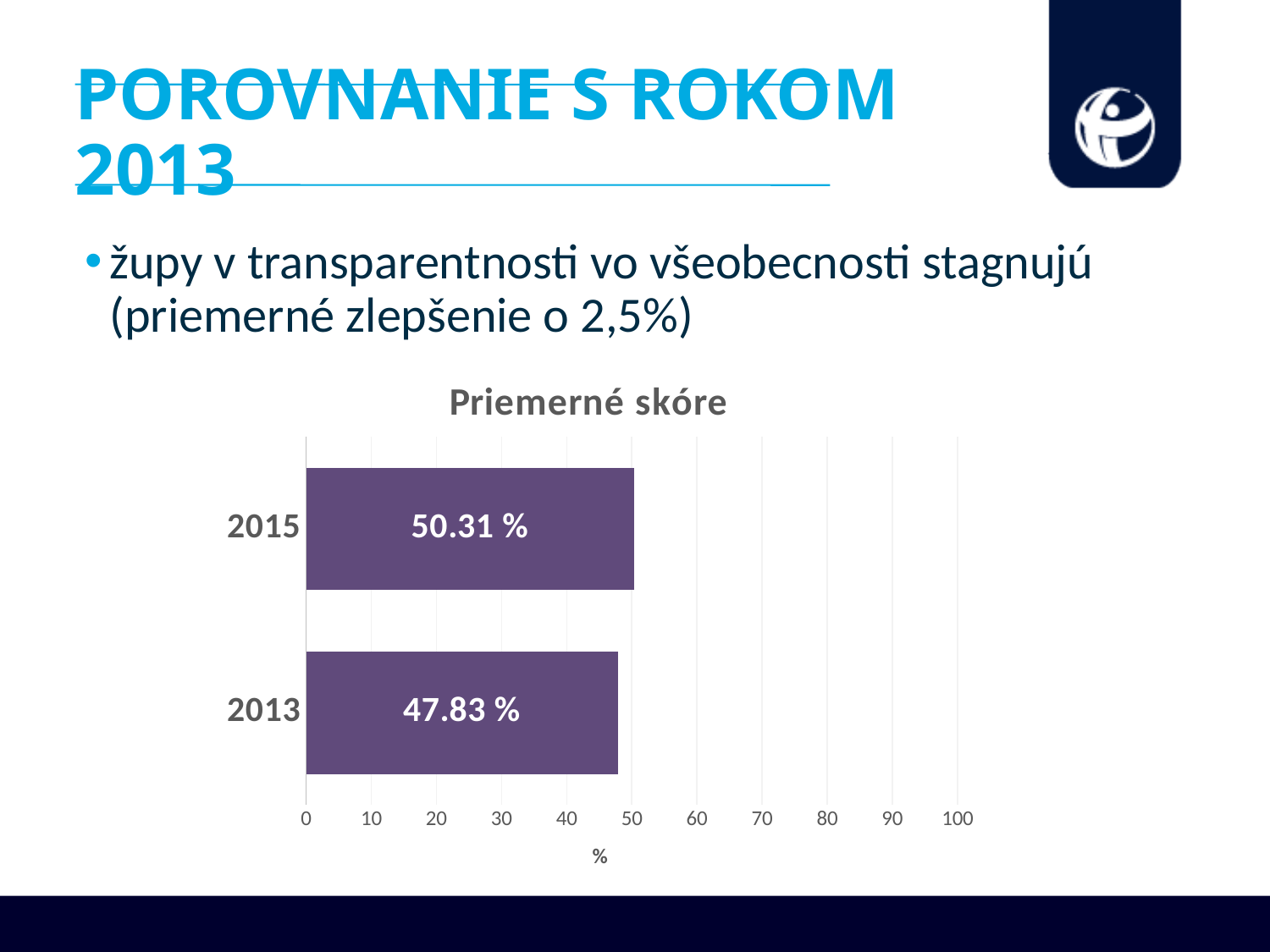
What is the title of the chart? Priemerné skóre What kind of chart is shown on the slide? Bar chart What is the value for 2013? 47.83 % Is the value for 2015 larger than the value for 2013? Yes Is the value for 2013 greater or less than 50? less What is the difference between the 2015 and 2013 values? 2.48 % How many categories are shown in the chart? 2 Is the value for 2015 greater or less than 40? greater What is the label of the horizontal axis? % What is the value for 2015? 50.31 % Which year has the higher average score? 2015 Which year has the lower average score? 2013